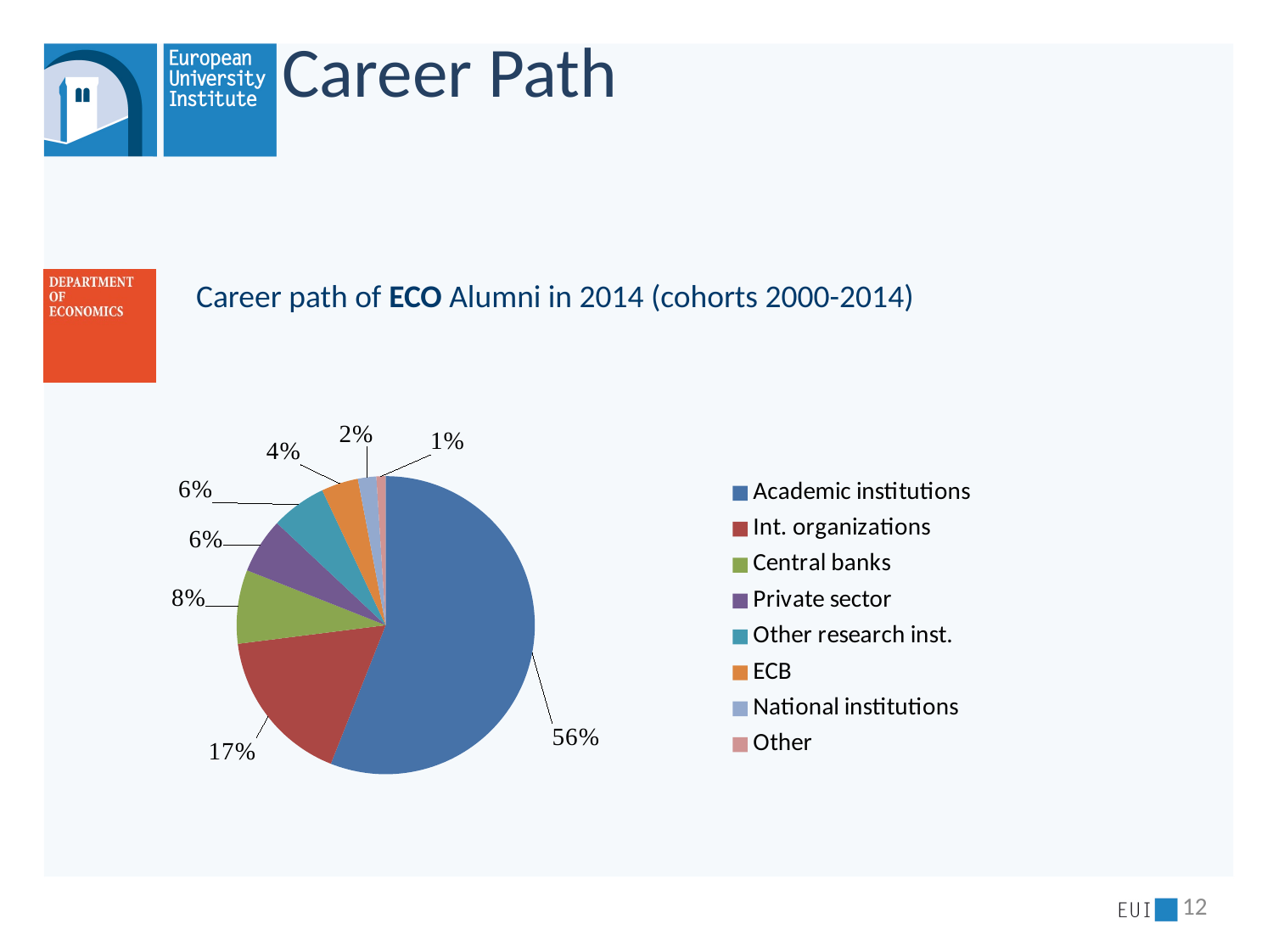
What share of ECO alumni are in international organizations? 17% What share of ECO alumni are in central banks? 8% What share of ECO alumni are in national institutions? 2% What share of ECO alumni are at the ECB? 4% What share of ECO alumni are in academic institutions? 56% Which category has the largest share of the pie? Academic institutions How many categories does the legend list? 8 What kind of chart is shown on the slide? Pie chart What is the title of the chart? Career path of ECO Alumni in 2014 (cohorts 2000-2014) What is the difference in percentage points between academic institutions and international organizations? 39 Which category has the smallest share of the pie? Other Which is larger, the share for central banks or the share for the ECB? Central banks